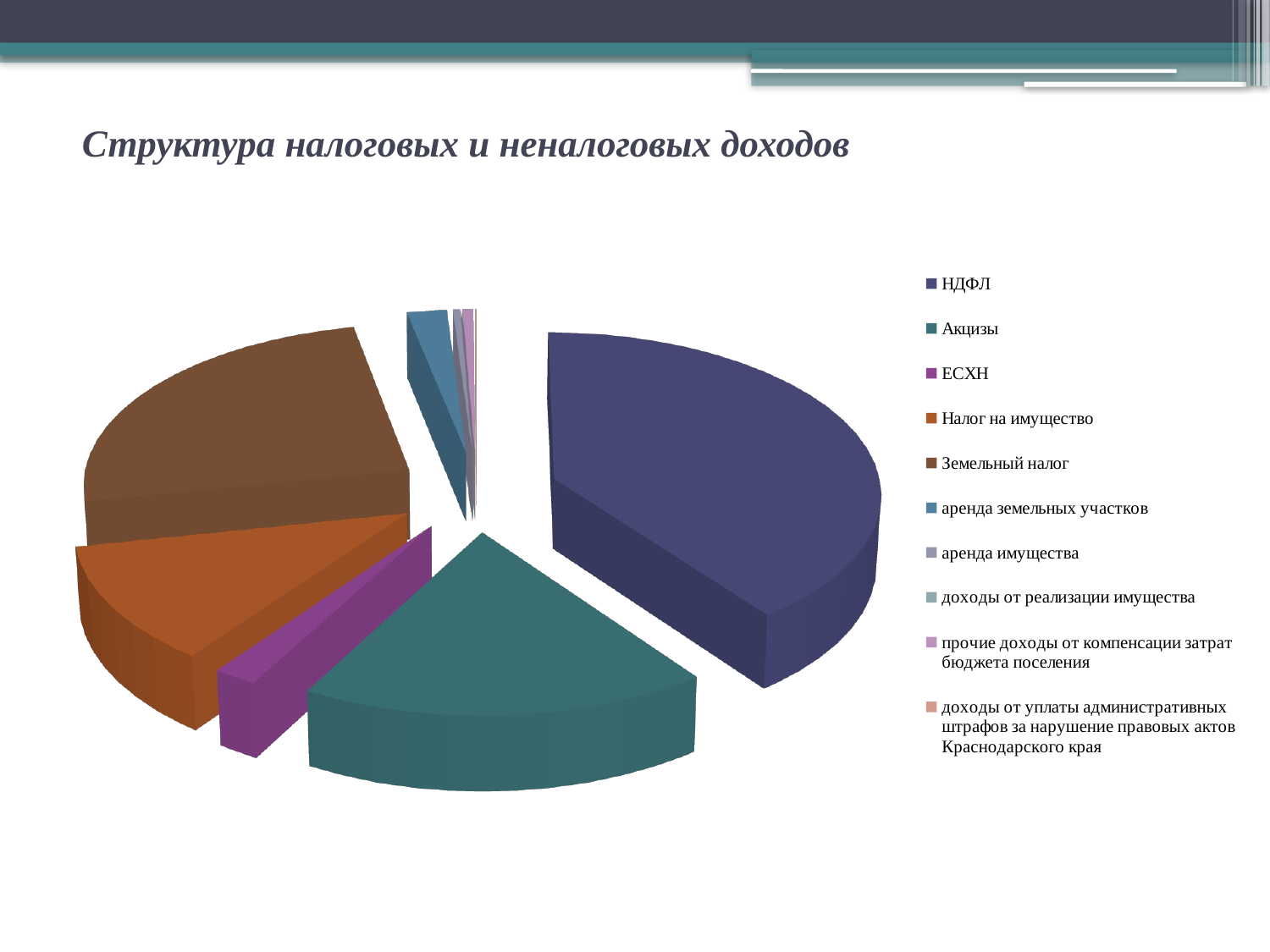
What kind of chart is shown on the slide? pie chart Which slice is larger, Земельный налог or ЕСХН? Земельный налог Which slice is larger, НДФЛ or Акцизы? НДФЛ Which slice is larger, Акцизы or аренда имущества? Акцизы What colour is the slice for Налог на имущество? orange Which category has the largest slice of the pie? НДФЛ Which legend entry is listed first? НДФЛ What is the title of the chart? Структура налоговых и неналоговых доходов How many categories does the legend of the pie chart list? 10